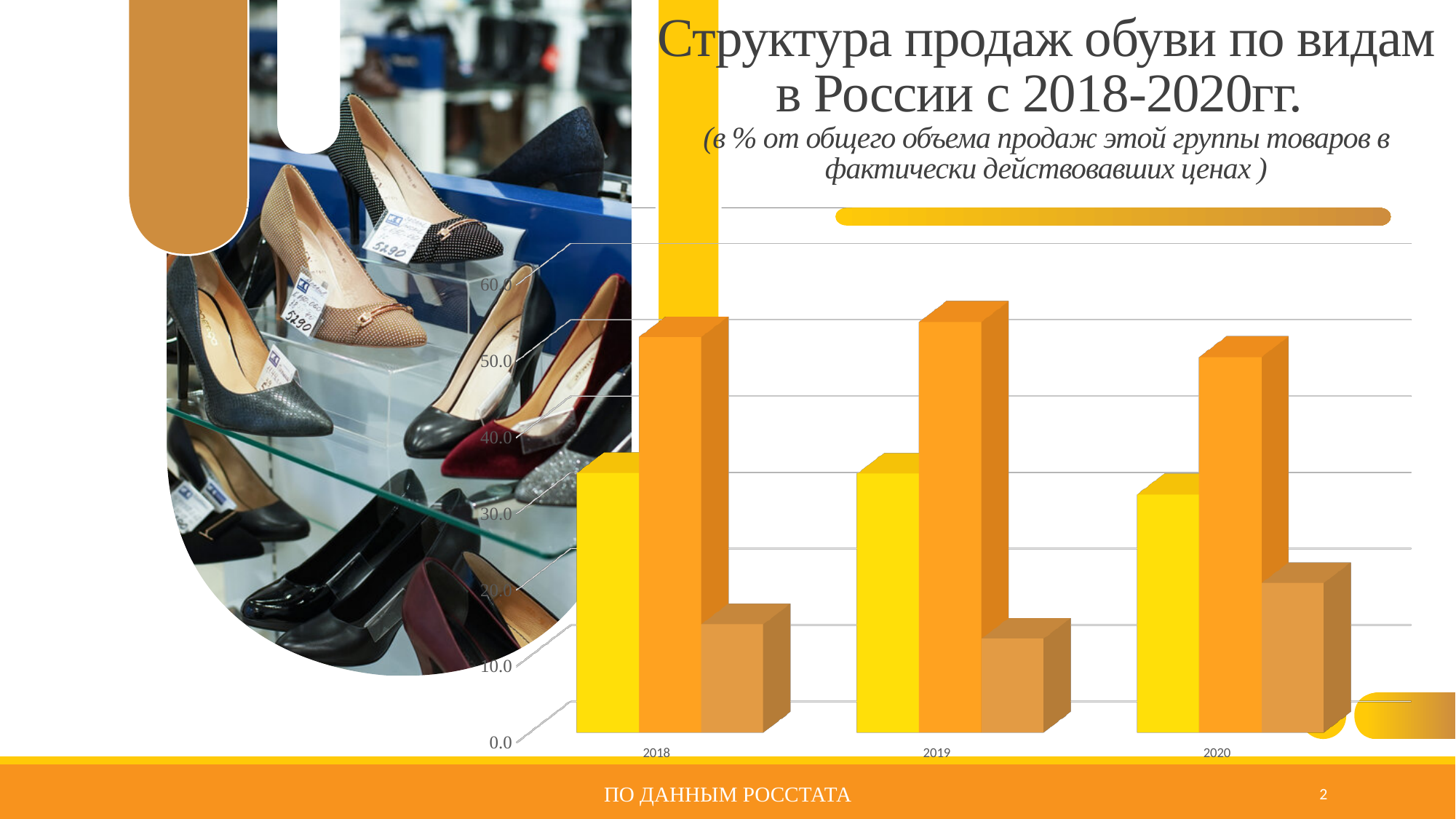
Is the value of the orange bar for 2019 greater or less than 50? greater Is the value of the yellow bar for 2018 greater or less than 30? greater In 2018, which is larger: the orange bar or the yellow bar? The orange bar Is the value of the brown bar for 2019 greater or less than 20? less Which bar is the lowest in the whole chart? The brown bar for 2019 How many years (categories) are shown on the x axis of the chart? 3 Which years are shown on the x axis of the chart? 2018, 2019, 2020 In which year is the orange bar the highest? 2019 What kind of chart is shown on the slide? Bar chart Which is larger: the brown bar for 2019 or the brown bar for 2020? The brown bar for 2020